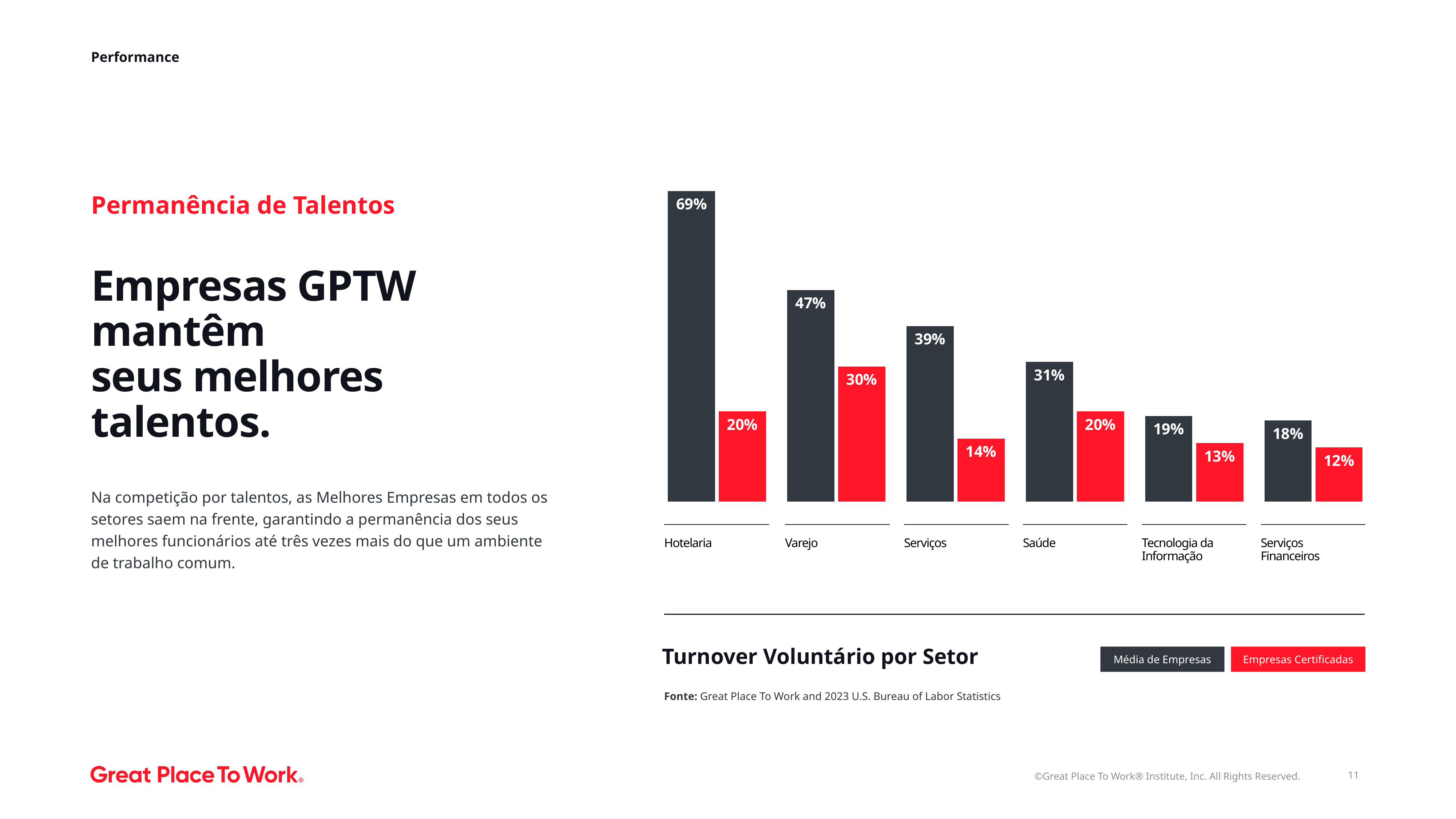
What is the value for Média de Empresas in Hotelaria? 69% What is the value for Empresas Certificadas in Serviços? 14% How many series does the legend list? 2 What is the difference between Média de Empresas and Empresas Certificadas in Hotelaria? 49% Which sector has the highest value for Média de Empresas? Hotelaria What kind of chart is shown on the slide? Bar chart How many sectors are shown on the chart? 6 What is the value for Empresas Certificadas in Varejo? 30% What is the value for Média de Empresas in Tecnologia da Informação? 19% Which is larger: Empresas Certificadas in Varejo or Empresas Certificadas in Saúde? Empresas Certificadas in Varejo What is the title of the chart? Turnover Voluntário por Setor Which sector has the lowest value for Empresas Certificadas? Serviços Financeiros